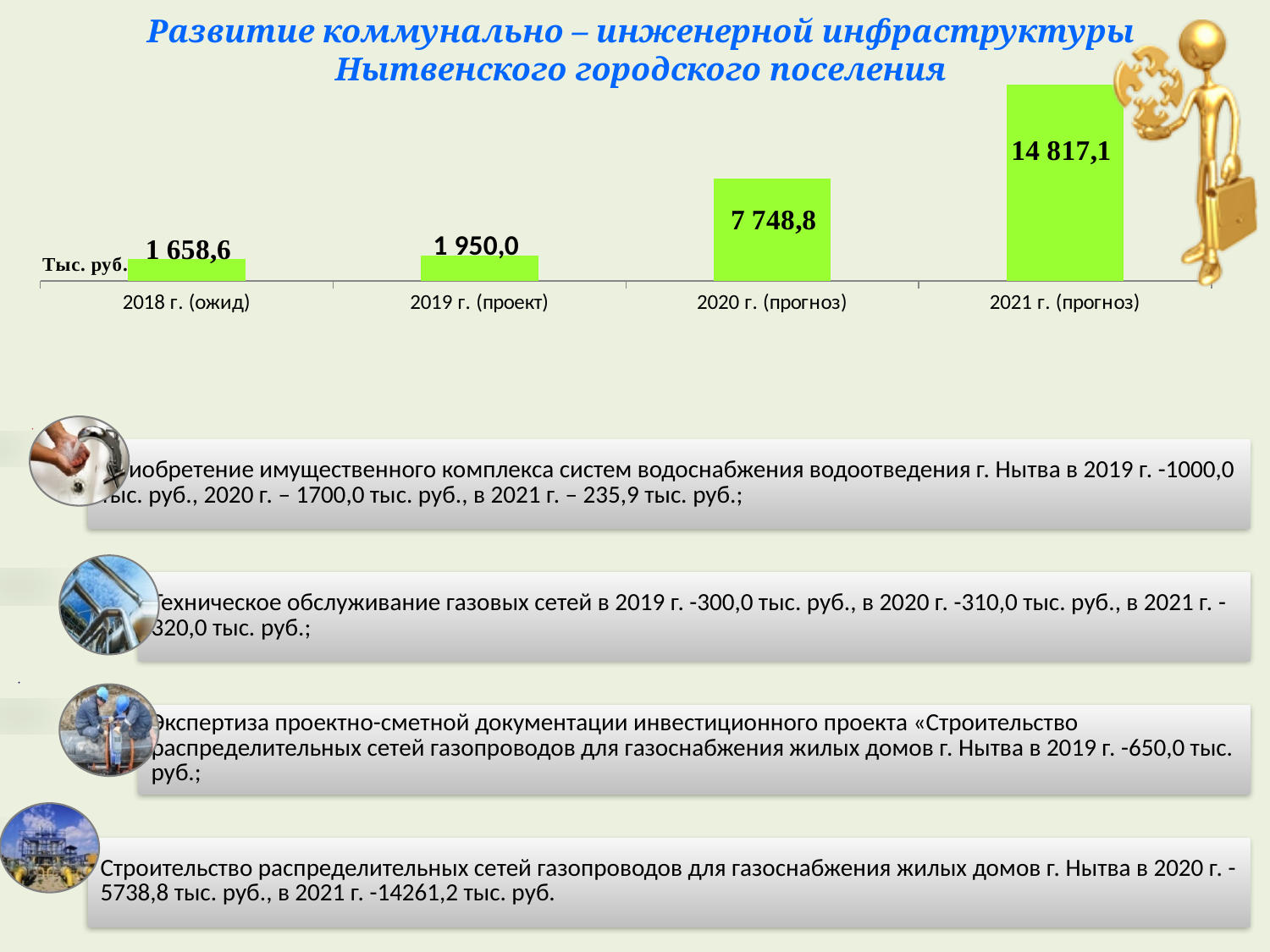
What kind of chart is shown on the slide? bar chart What is the value for 2018 г. (ожид)? 1 658,6 Which is larger, the value for 2020 г. (прогноз) or the value for 2019 г. (проект)? 2020 г. (прогноз) How many categories are shown on the chart? 4 What is the difference between the values for 2021 г. (прогноз) and 2020 г. (прогноз)? 7 068,3 Which category has the lowest value? 2018 г. (ожид) What is the value for 2020 г. (прогноз)? 7 748,8 What is the value for 2021 г. (прогноз)? 14 817,1 What is the value for 2019 г. (проект)? 1 950,0 What is the difference between the values for 2019 г. (проект) and 2018 г. (ожид)? 291,4 Which category has the highest value? 2021 г. (прогноз) Do the values rise or fall from 2018 г. (ожид) to 2021 г. (прогноз)? rise